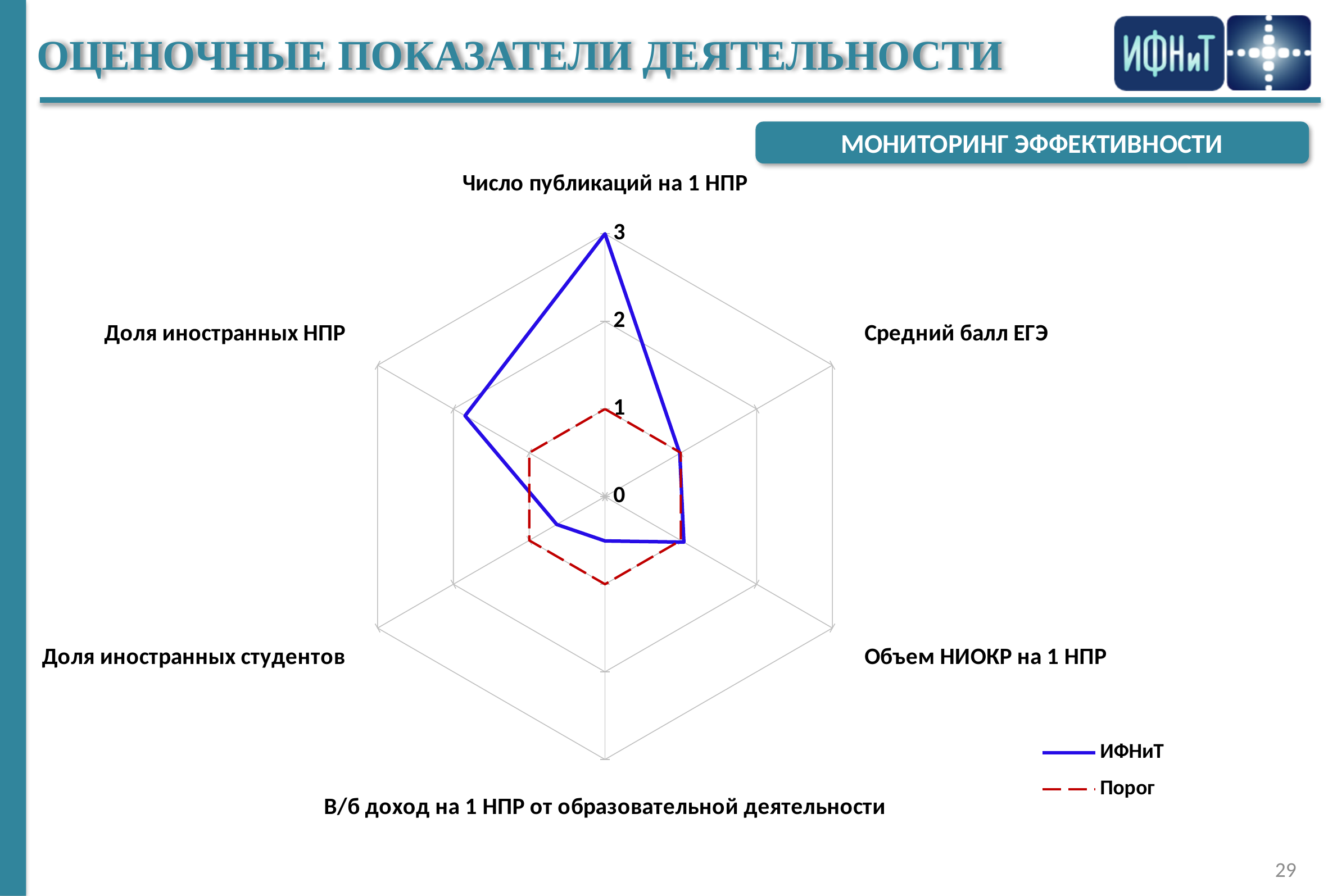
Is the ИФНиТ value for Доля иностранных НПР greater or less than 1? greater Is the ИФНиТ value for Доля иностранных НПР greater or less than 3? less How many series does the legend list? 2 What is the value of Порог for Число публикаций на 1 НПР? 1 For ИФНиТ, which is larger: Число публикаций на 1 НПР or Доля иностранных студентов? Число публикаций на 1 НПР Is the ИФНиТ value for Доля иностранных студентов greater or less than 1? less What is the value of ИФНиТ for Число публикаций на 1 НПР? 3 On which indicator does ИФНиТ have its highest value? Число публикаций на 1 НПР Which series is drawn with a red dashed line? Порог What kind of chart is shown on the slide? Radar chart How many indicator axes (categories) does the radar chart have? 6